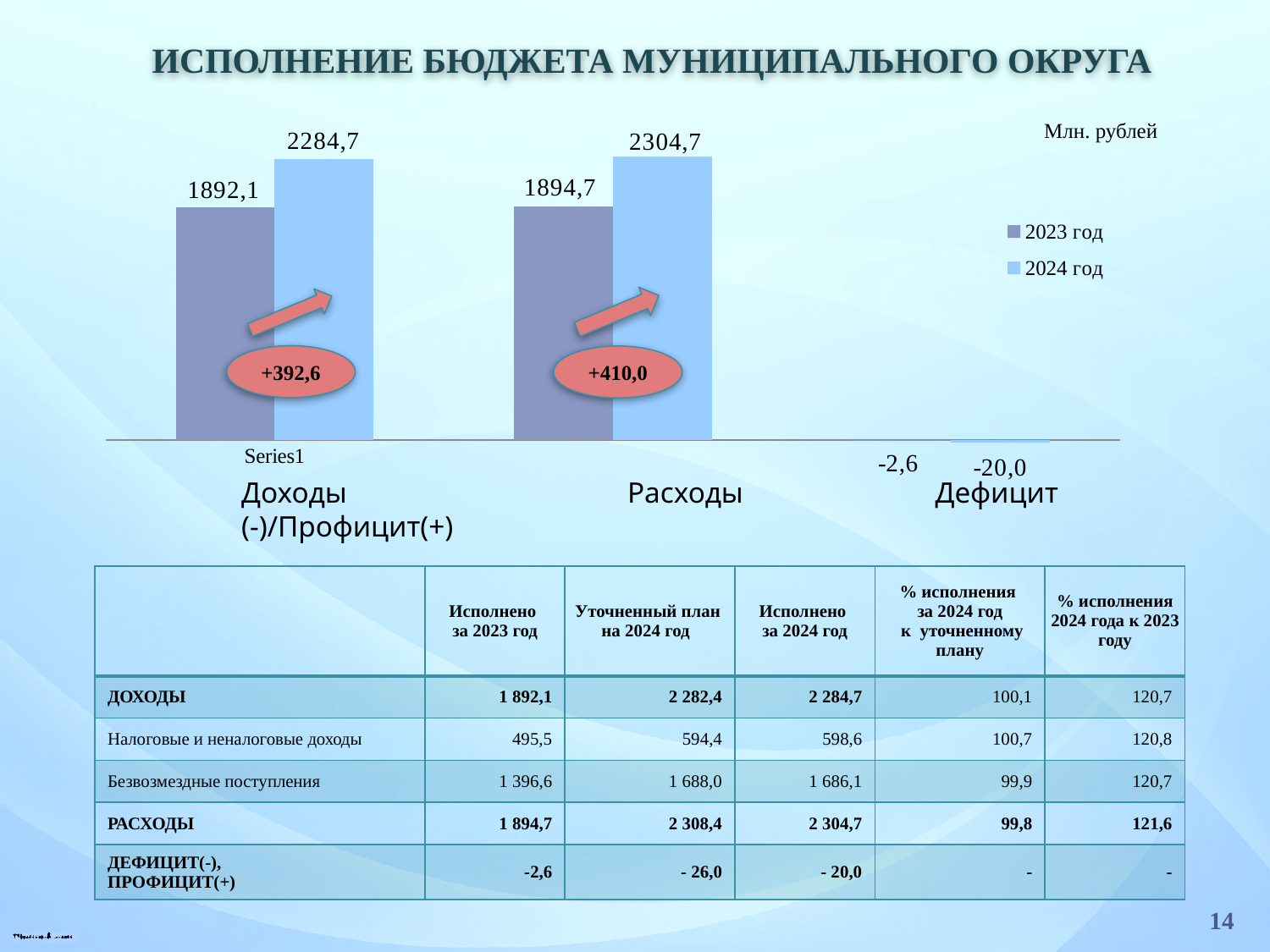
What is the value for Дефицит(-)/Профицит(+) in 2023 год on the chart? -2,6 Which category has the lowest value for 2023 год on the chart? Дефицит(-)/Профицит(+) What is the value for Доходы in 2024 год on the chart? 2284,7 Which is larger on the chart: Расходы in 2024 год or Доходы in 2024 год? Расходы in 2024 год Which category has the highest value for 2024 год on the chart? Расходы What is the value for Расходы in 2024 год on the chart? 2304,7 What is the value for Дефицит(-)/Профицит(+) in 2024 год on the chart? -20,0 What type of chart is shown on the slide? Bar chart What is the value for Расходы in 2023 год on the chart? 1894,7 What is the value for Доходы in 2023 год on the chart? 1892,1 How many series does the chart legend list? 2 What is the difference between the 2024 год and 2023 год values for Доходы on the chart? 392,6